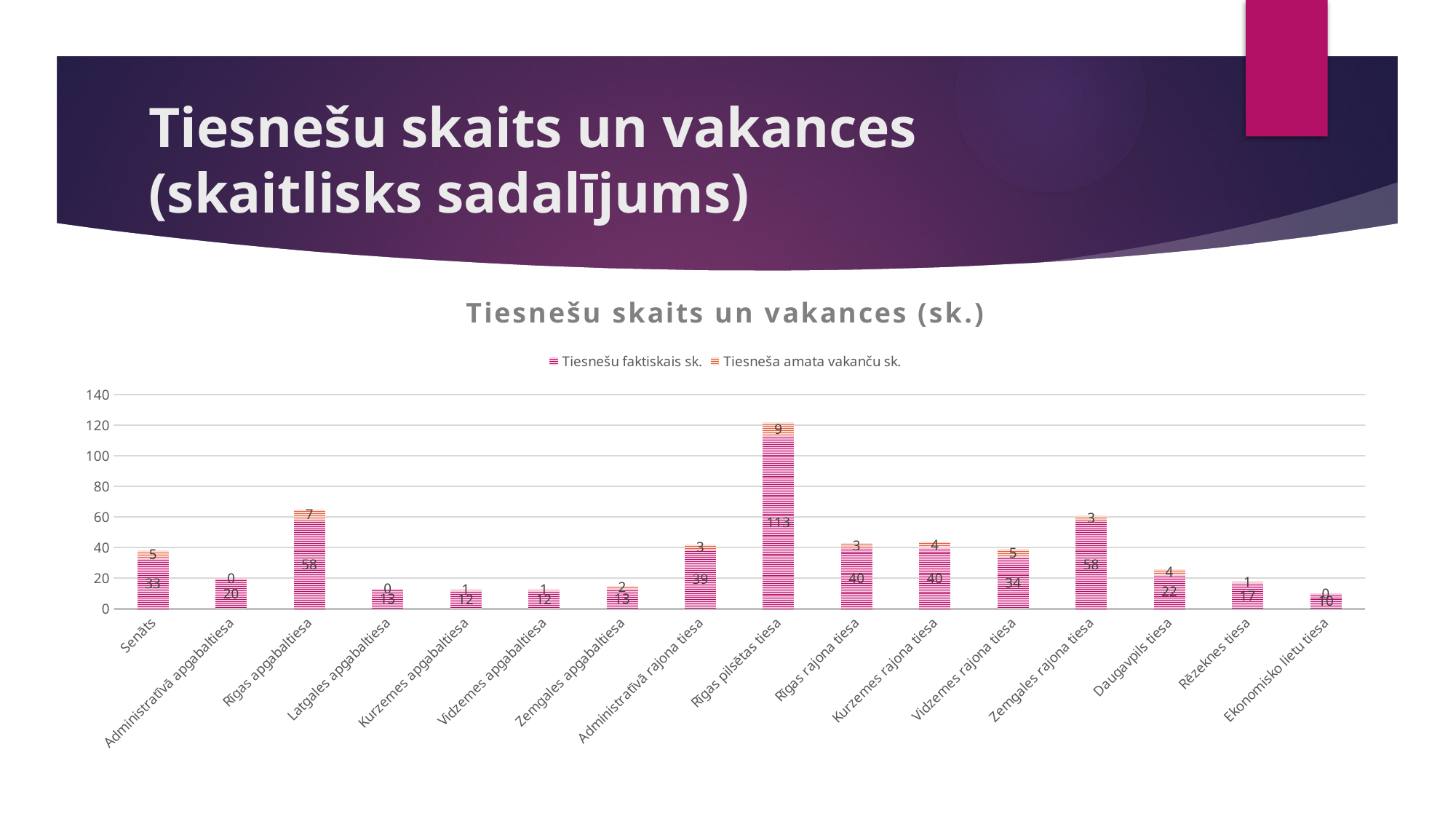
Which court has the highest value for 'Tiesnešu faktiskais sk.'? Rīgas pilsētas tiesa Which is larger: 'Tiesnešu faktiskais sk.' for Administratīvā rajona tiesa or for Vidzemes rajona tiesa? Administratīvā rajona tiesa What is the title of the chart? Tiesnešu skaits un vakances (sk.) What is the value of 'Tiesneša amata vakanču sk.' for Rīgas apgabaltiesa? 7 How many series does the legend list? 2 What is the total of the stacked bar for Rīgas pilsētas tiesa? 122 Which court has the lowest value for 'Tiesnešu faktiskais sk.'? Ekonomisko lietu tiesa What is the value of 'Tiesnešu faktiskais sk.' for Rīgas pilsētas tiesa? 113 What is the difference between 'Tiesnešu faktiskais sk.' for Rīgas apgabaltiesa and for Senāts? 25 How many courts (categories) are shown on the x axis? 16 What is the value of 'Tiesnešu faktiskais sk.' for Daugavpils tiesa? 22 What kind of chart is shown on the slide? Stacked bar chart